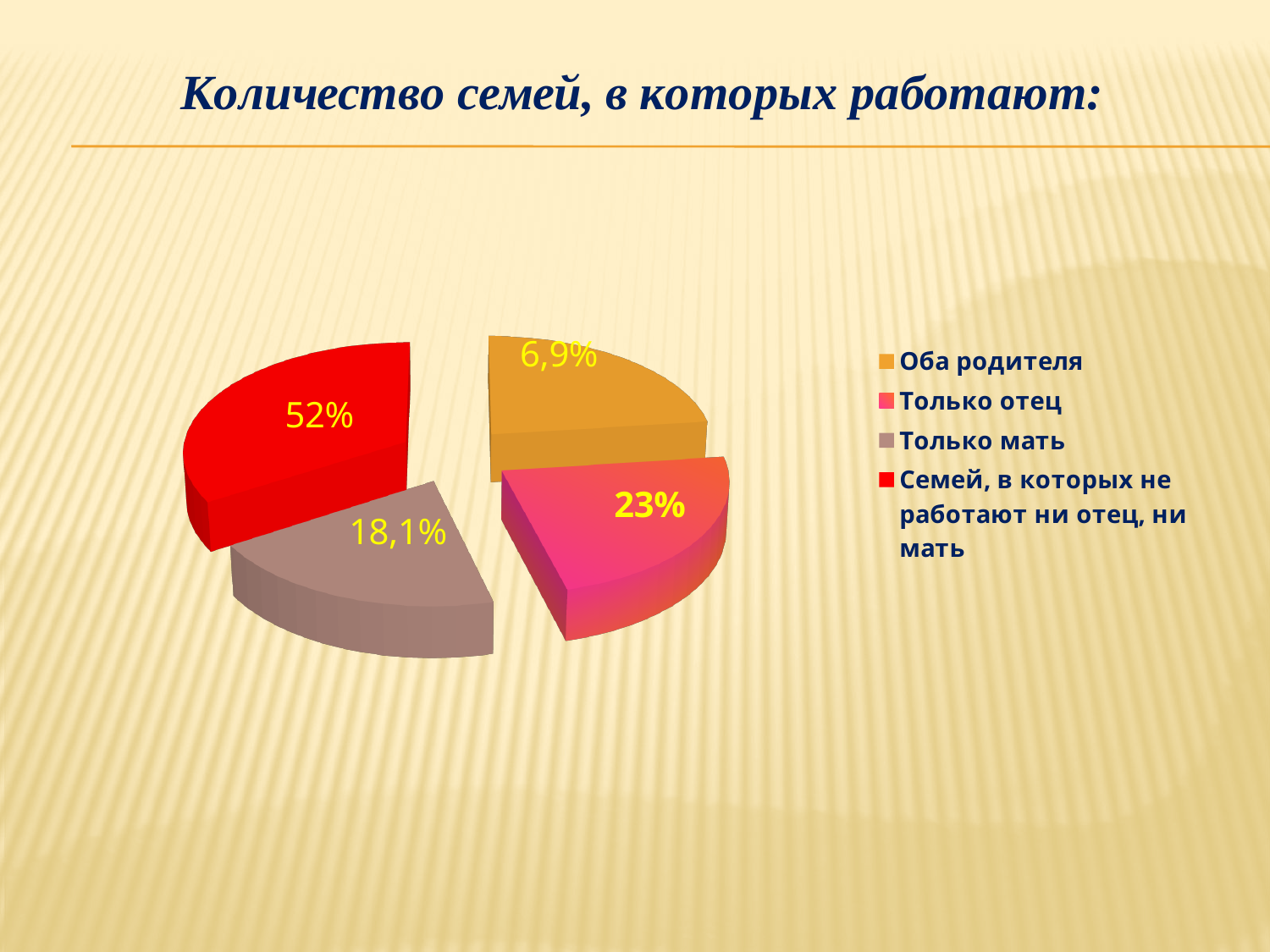
What is the difference between the values for "Только отец" and "Только мать"? 4,9% What is the title of the chart? Количество семей, в которых работают: What value is shown for "Только отец"? 23% Which is larger, the value for "Только отец" or the value for "Только мать"? Только отец What kind of chart is shown on the slide? pie chart Which category has the largest slice of the pie? Семей, в которых не работают ни отец, ни мать Which category has the smallest labelled value? Оба родителя What share of the pie is labelled for "Семей, в которых не работают ни отец, ни мать"? 52% How many slices does the pie chart have? 4 What colour is the slice for "Семей, в которых не работают ни отец, ни мать"? red What value is shown for "Оба родителя"? 6,9% What value is shown for "Только мать"? 18,1%